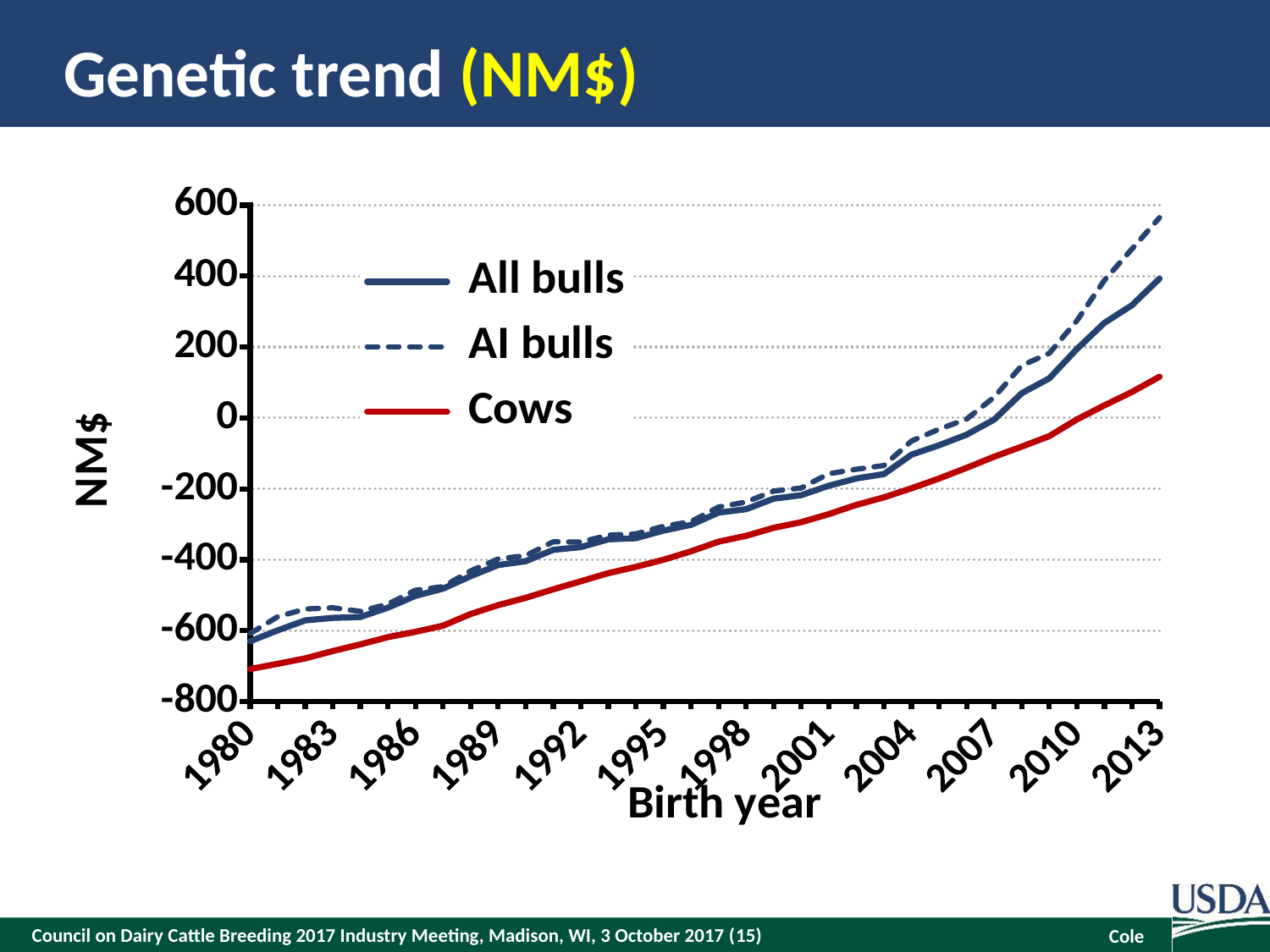
Which series has the lowest values across the whole chart? Cows How many series does the legend list? 3 Which series is drawn with a dashed line? AI bulls Is the value for AI bulls in 2013 greater or less than 400? greater What kind of chart is shown on the slide? line chart Do the NM$ values for All bulls rise or fall as birth year increases from 1980 to 2013? rise Is the value for All bulls in 1980 greater or less than -600? less Is the value for Cows in 1980 greater or less than -600? less In 2013, which series has the higher value, AI bulls or Cows? AI bulls In 2013, which series has the higher value, AI bulls or All bulls? AI bulls